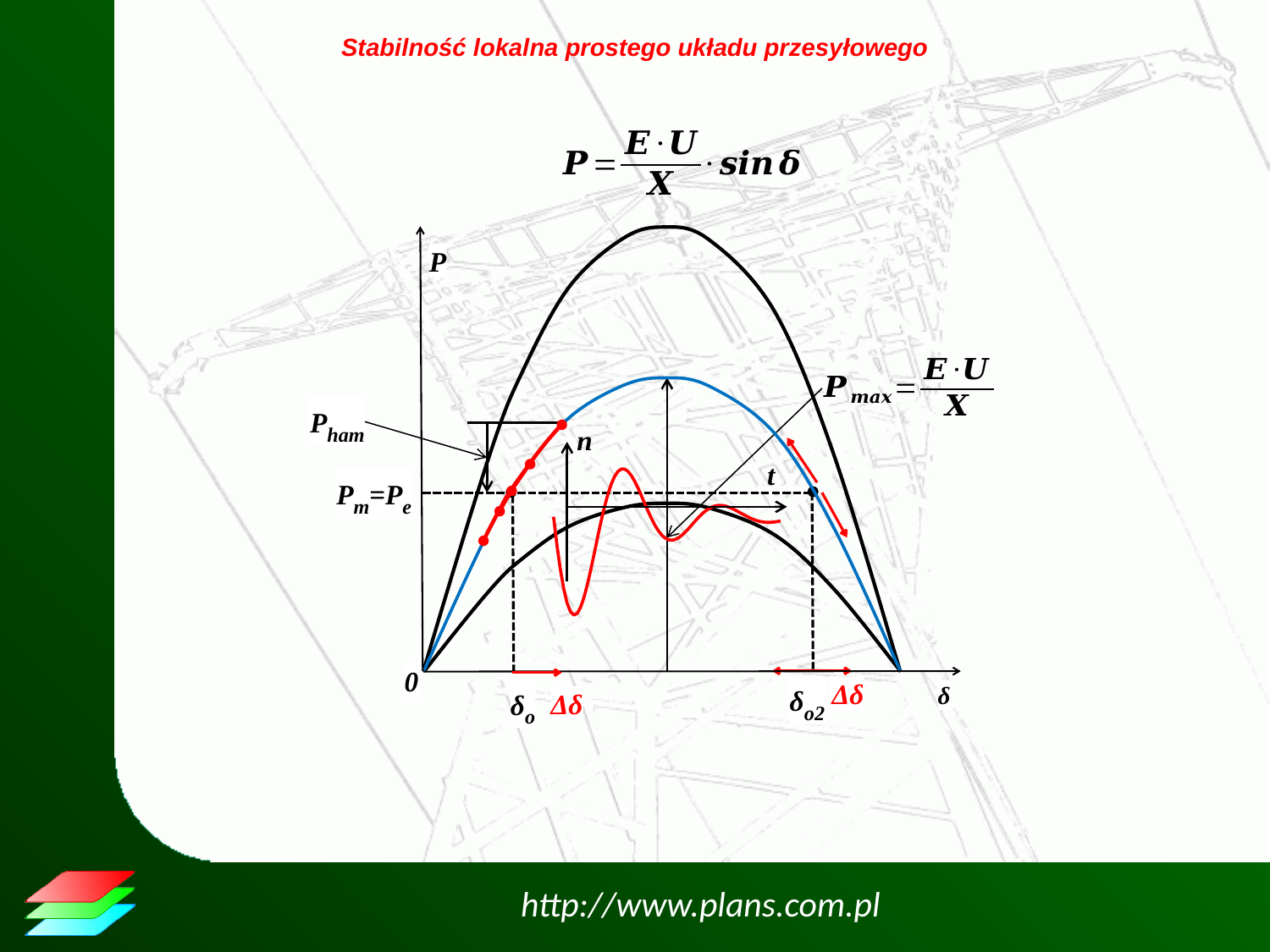
Does the blue curve rise or fall as δ increases from 0 to δo? rise How many arch-shaped power curves are drawn on the chart? 3 What is the label of the horizontal axis of the chart? δ Does the blue curve rise or fall as δ increases from δo2 towards the right end of the axis? fall What kind of chart is shown on the slide? line chart What is the label of the vertical axis of the chart? P